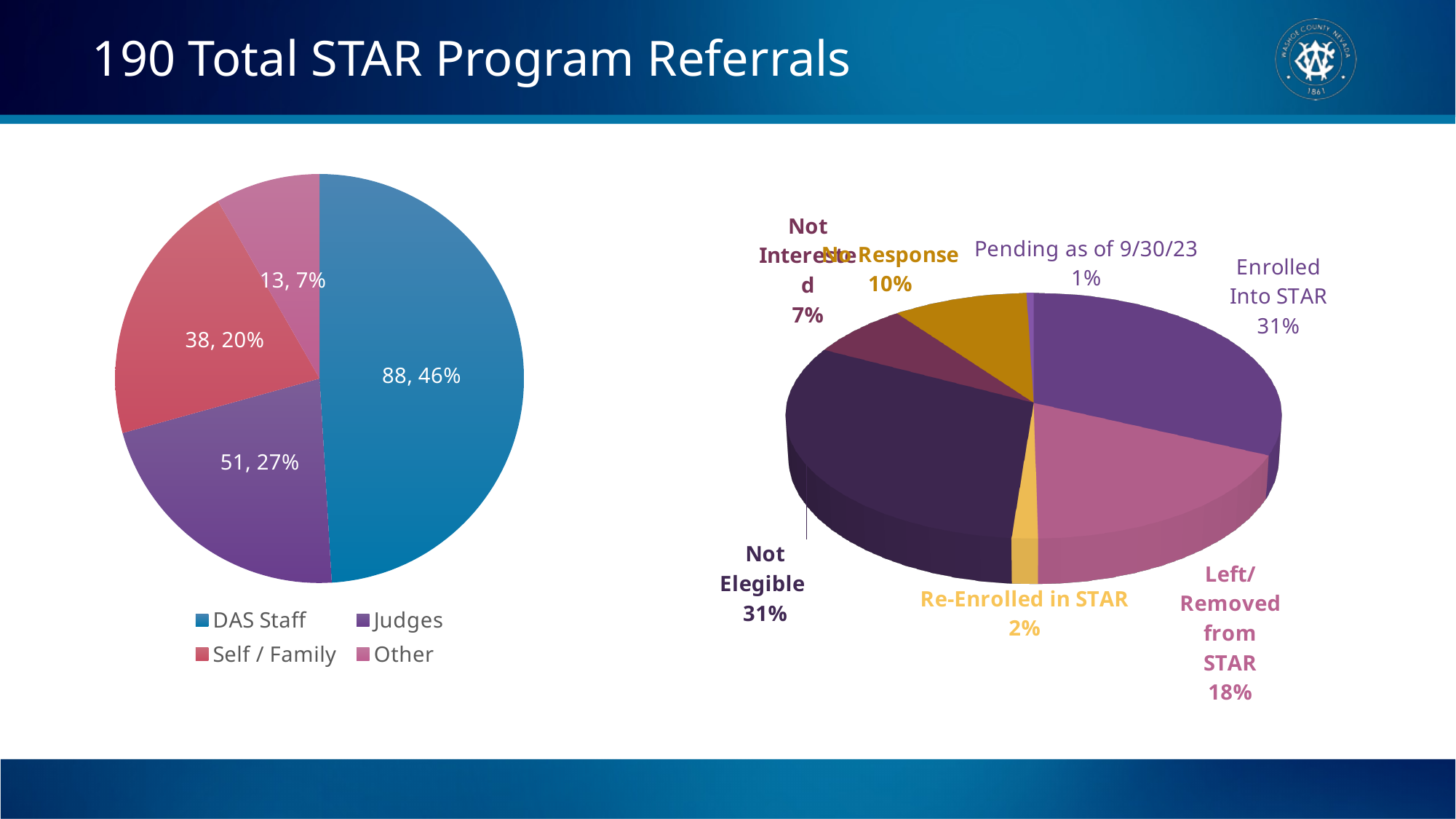
In the pie chart on the left, how many categories does the legend list? 4 In the pie chart on the right, how many categories are shown? 7 What type of chart is shown on the left of the slide? Pie chart In the pie chart on the left, what percentage of referrals came from Judges? 27% In the pie chart on the right, what percentage of referrals were Enrolled Into STAR? 31% In the pie chart on the left, how many referrals came from DAS Staff? 88 In the pie chart on the right, what percentage of referrals were Left/Removed from STAR? 18% In the pie chart on the left, which referral source has the largest slice? DAS Staff In the pie chart on the right, which is larger: No Response or Not Interested? No Response In the pie chart on the left, how many more referrals came from Judges than from Self / Family? 13 In the pie chart on the left, which referral source has the smallest slice? Other In the pie chart on the right, which category has the smallest share? Pending as of 9/30/23